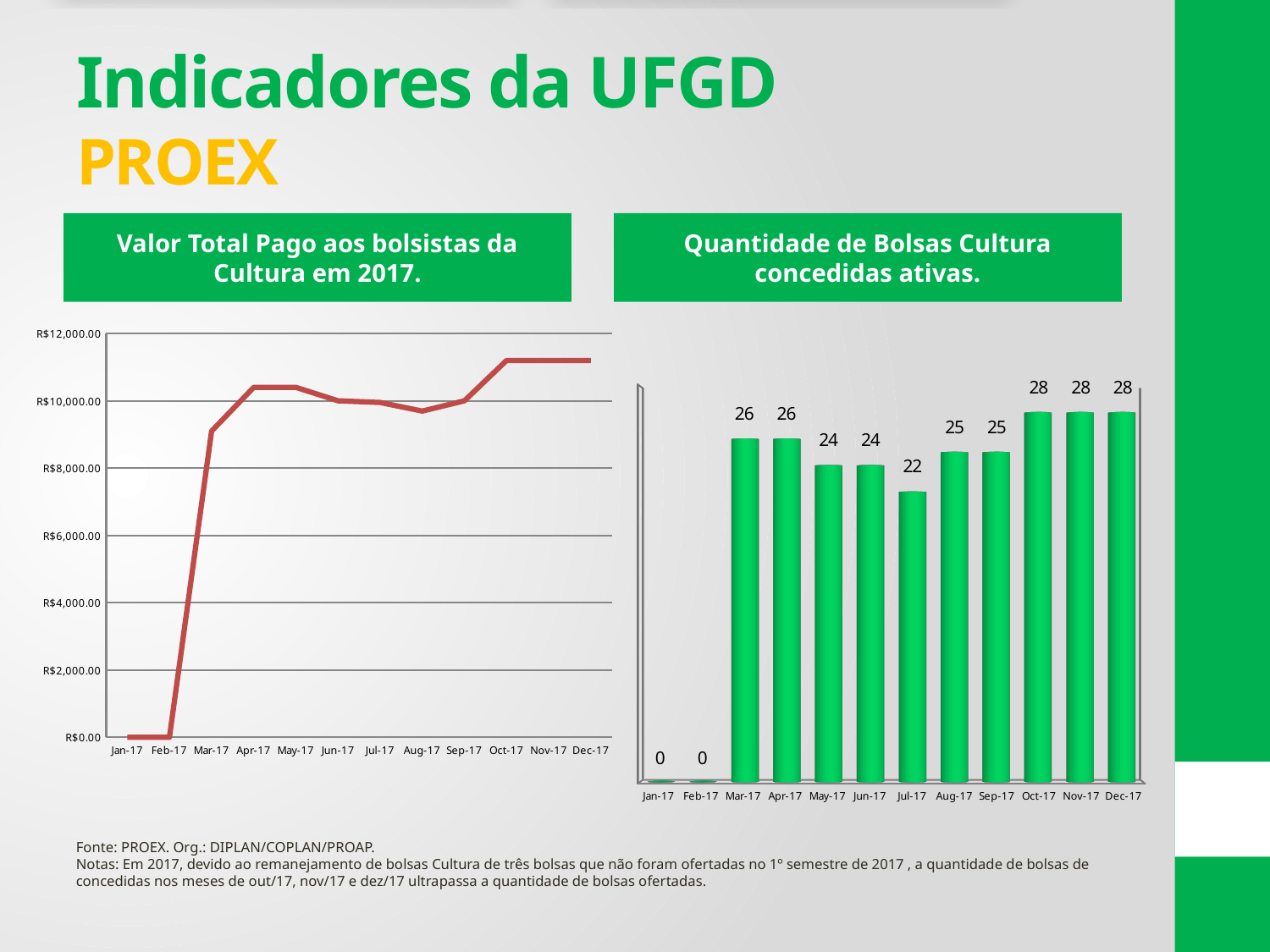
In the chart 'Quantidade de Bolsas Cultura concedidas ativas.', what is the value for Jul-17? 22 What kind of chart is 'Valor Total Pago aos bolsistas da Cultura em 2017.'? Line chart In the chart 'Quantidade de Bolsas Cultura concedidas ativas.', what is the value for Mar-17? 26 In the chart 'Quantidade de Bolsas Cultura concedidas ativas.', which is larger, the value for Mar-17 or the value for May-17? Mar-17 In the chart 'Quantidade de Bolsas Cultura concedidas ativas.', what is the difference between the values for Dec-17 and Jul-17? 6 What kind of chart is 'Quantidade de Bolsas Cultura concedidas ativas.'? Bar chart In the chart 'Quantidade de Bolsas Cultura concedidas ativas.', which month has the lowest non-zero value? Jul-17 How many months are shown on the x axis of the chart 'Quantidade de Bolsas Cultura concedidas ativas.'? 12 In the chart 'Valor Total Pago aos bolsistas da Cultura em 2017.', is the value for Mar-17 greater or less than R$8,000.00? greater In the chart 'Quantidade de Bolsas Cultura concedidas ativas.', what is the value for Dec-17? 28 In the chart 'Valor Total Pago aos bolsistas da Cultura em 2017.', what is the value for Jan-17? R$0.00 In the chart 'Valor Total Pago aos bolsistas da Cultura em 2017.', is the value for Dec-17 greater or less than R$10,000.00? greater